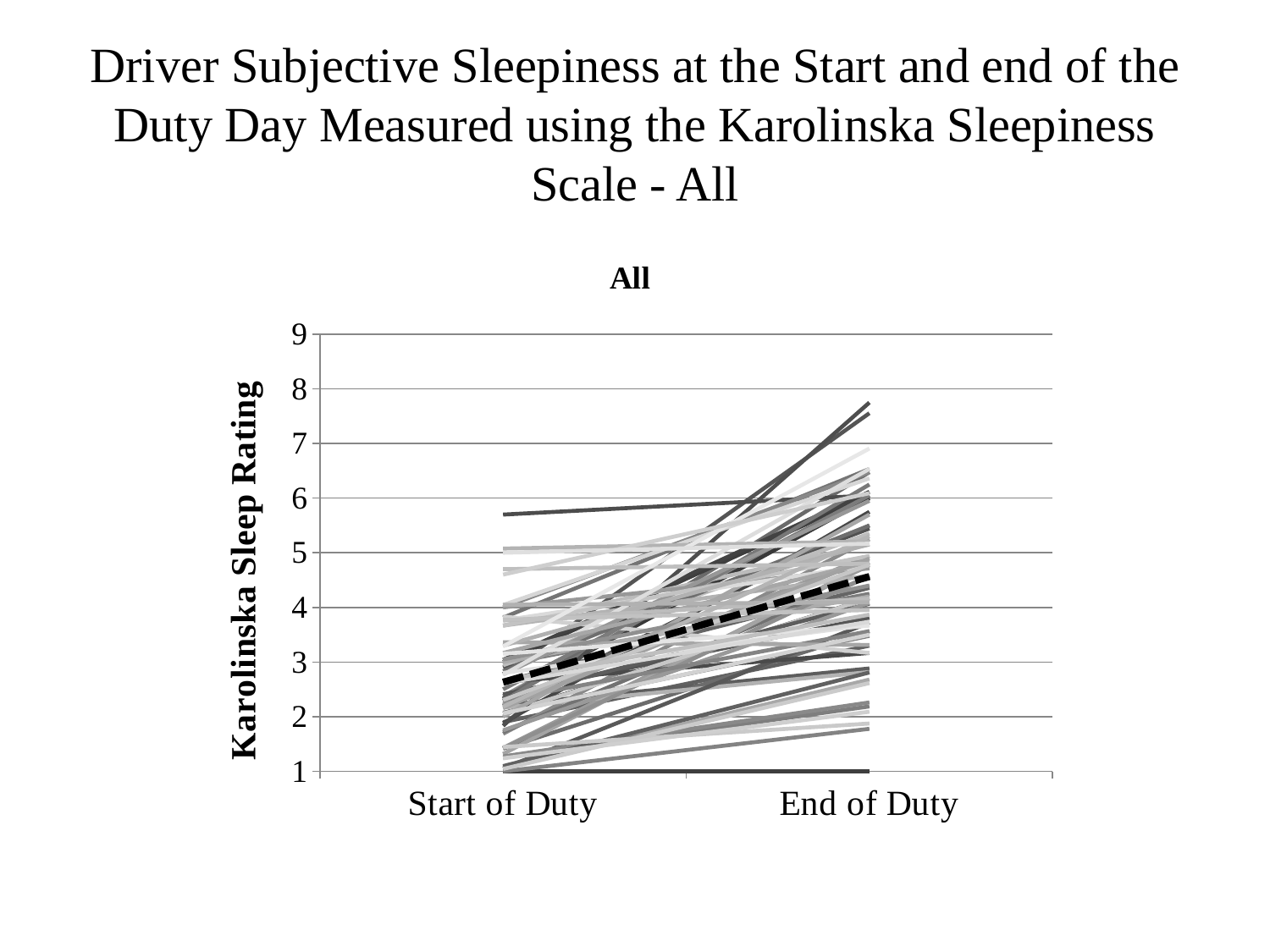
What are the two categories on the horizontal axis? Start of Duty and End of Duty Is the highest line value at End of Duty greater or less than 7? greater What is the maximum value shown on the vertical axis? 9 Is the value of the thick dashed line at End of Duty greater or less than 4? greater What is the label on the vertical axis of the chart? Karolinska Sleep Rating Does the thick dashed line rise or fall from Start of Duty to End of Duty? rise What kind of chart is shown on the slide? line chart Is the highest line value at Start of Duty greater or less than 6? less Is the thick dashed line higher at Start of Duty or at End of Duty? End of Duty How many categories are shown on the horizontal axis? 2